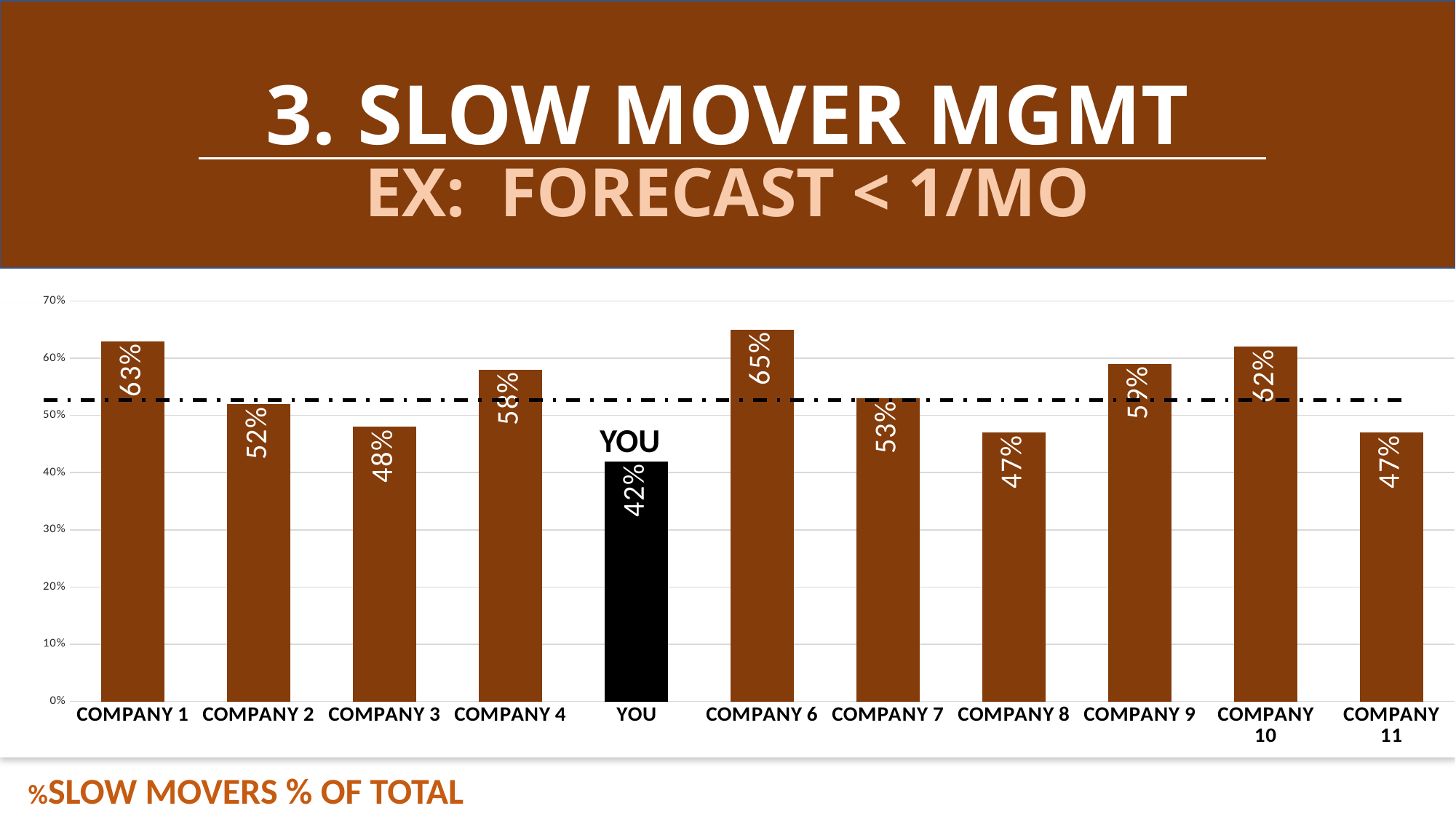
What kind of chart is shown on the slide? bar chart What is the value for COMPANY 1? 63% Which category has the highest value? COMPANY 6 What is the difference between the values for COMPANY 6 and YOU? 23% What is the difference between the values for COMPANY 10 and COMPANY 3? 14% Is the value for COMPANY 2 greater or less than 50%? greater What is the value for the bar labelled YOU? 42% What is the value for COMPANY 9? 59% How many bars are shown in the chart? 11 Which category has the lowest value? YOU What colour is the bar labelled YOU? black Which is larger, the value for COMPANY 4 or the value for COMPANY 7? COMPANY 4